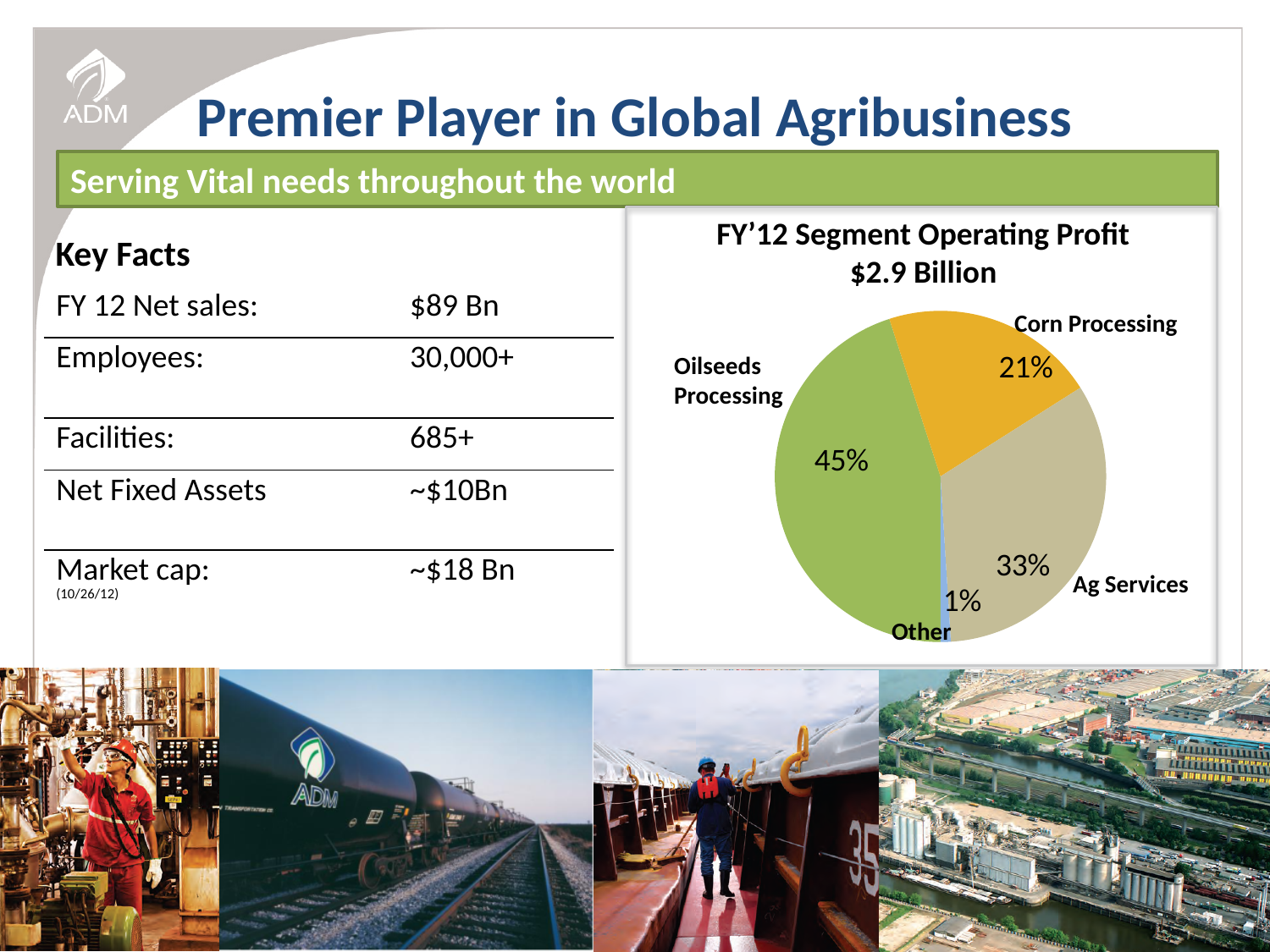
What kind of chart is shown on the slide? pie chart What share of FY'12 segment operating profit comes from Other? 1% What share of FY'12 segment operating profit comes from Oilseeds Processing? 45% What is the title of the chart? FY'12 Segment Operating Profit $2.9 Billion What is the difference in percentage points between the Oilseeds Processing and Ag Services shares? 12 What share of FY'12 segment operating profit comes from Ag Services? 33% Which segment has the largest share of FY'12 segment operating profit? Oilseeds Processing How many segments are shown in the pie chart? 4 Which segment has a larger share, Corn Processing or Ag Services? Ag Services What share of FY'12 segment operating profit comes from Corn Processing? 21% Which segment has the smallest share of FY'12 segment operating profit? Other What is the combined share of Corn Processing and Ag Services? 54%